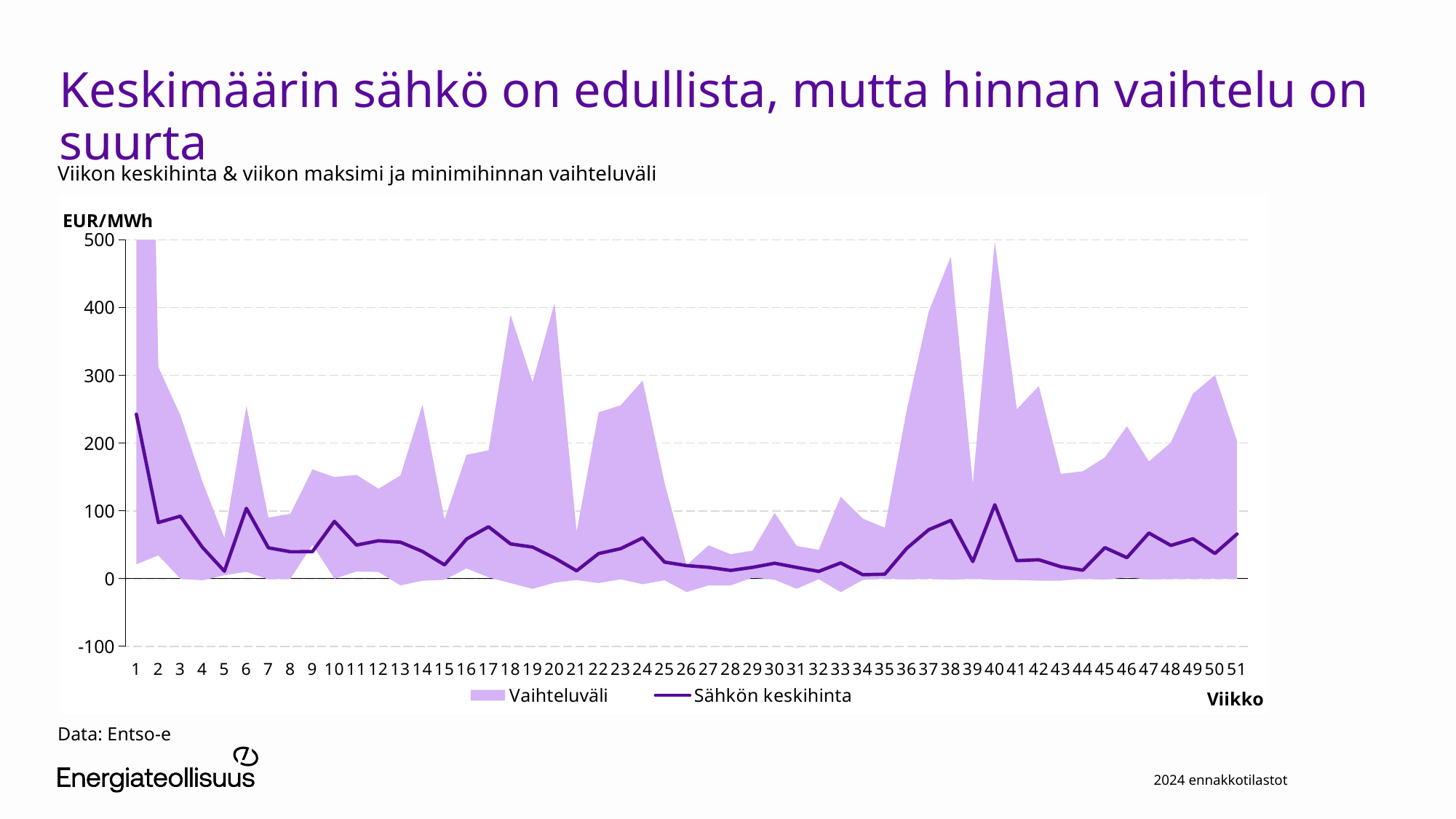
Which week has the higher average electricity price, week 1 or week 30? week 1 What kind of chart is shown on the slide? combination area and line chart Is the upper end of the price range (Vaihteluväli) in week 20 greater or less than 300? greater Is the upper end of the price range (Vaihteluväli) in week 40 greater or less than 400? greater How many weeks are shown on the x axis? 51 What is the data source given below the chart? Entso-e Does the average electricity price rise or fall from week 1 to week 5? fall Is the average electricity price in week 1 greater or less than 200? greater In which week is the average electricity price (Sähkön keskihinta) highest? 1 How many series does the legend list? 2 What unit is shown on the y axis of the chart? EUR/MWh